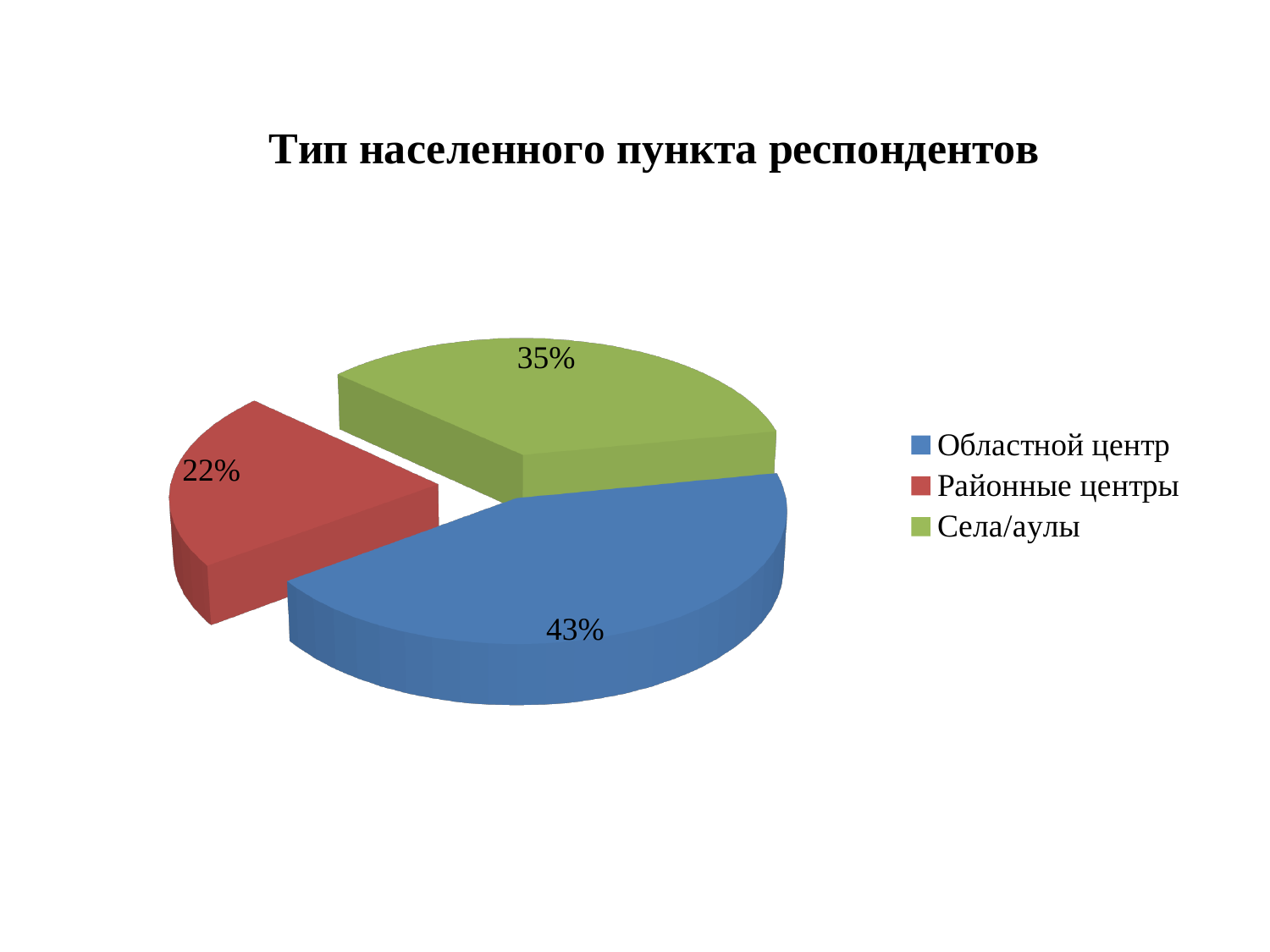
What share of respondents are from Районные центры? 22% Which colour represents Села/аулы in the chart? Green What share of respondents are from Села/аулы? 35% What kind of chart is shown on the slide? Pie chart What share of respondents are from Областной центр? 43% Which settlement type has the smallest share of respondents? Районные центры What is the title of the chart? Тип населенного пункта респондентов How many categories does the pie chart show? 3 Which settlement type has the largest share of respondents? Областной центр Which has a larger share, Села/аулы or Районные центры? Села/аулы What is the difference in percentage points between Областной центр and Села/аулы? 8 What is the difference in percentage points between Села/аулы and Районные центры? 13